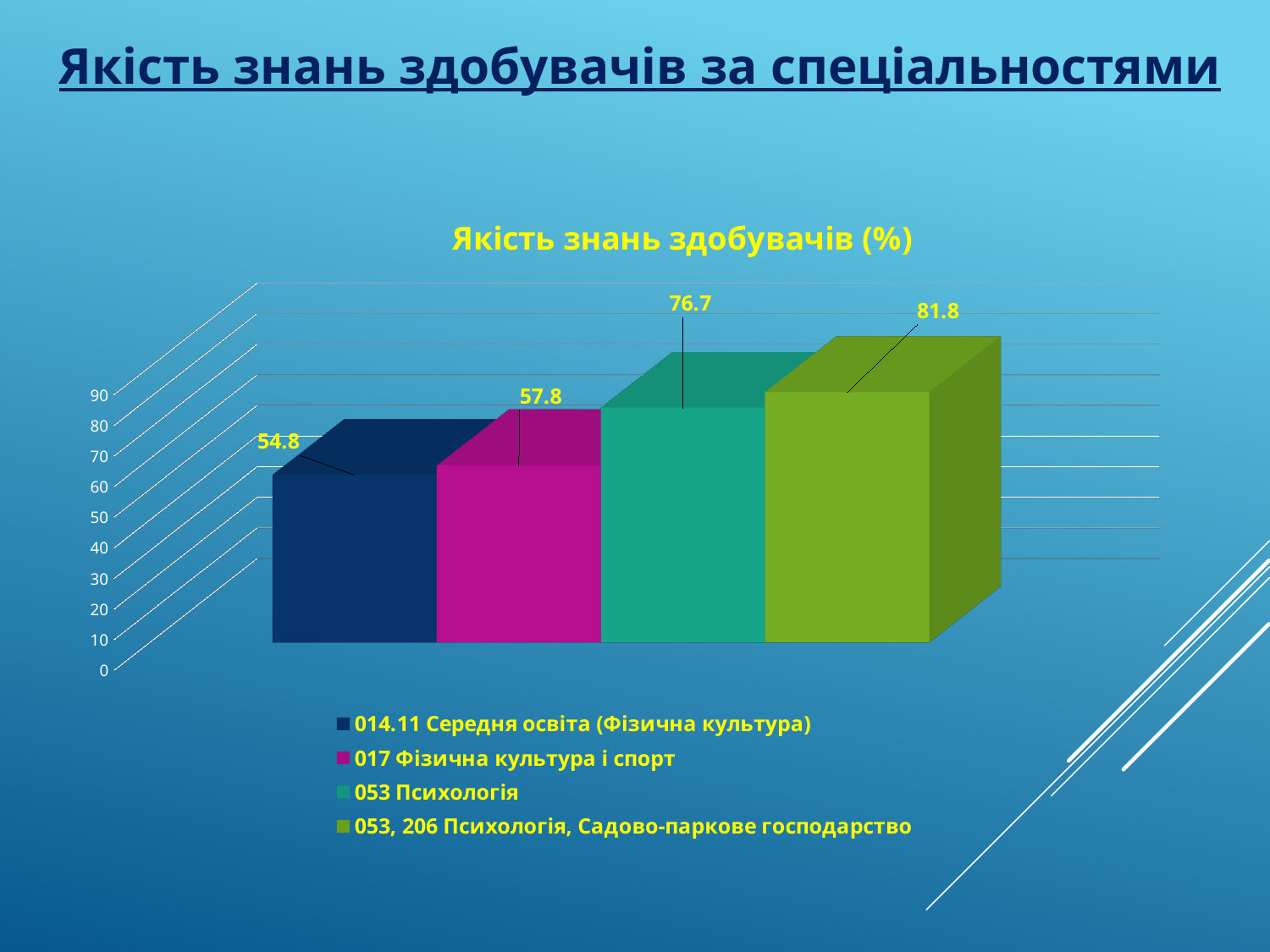
What is the value for 017 Фізична культура і спорт? 57.8 What is the value for 053 Психологія? 76.7 Which specialty has the highest value? 053, 206 Психологія, Садово-паркове господарство What is the difference between the values for 053 Психологія and 017 Фізична культура і спорт? 18.9 What kind of chart is shown on the slide? Bar chart What is the difference between the values for 053, 206 Психологія, Садово-паркове господарство and 014.11 Середня освіта (Фізична культура)? 27 How many bars are plotted in the chart? 4 What is the value for 053, 206 Психологія, Садово-паркове господарство? 81.8 Which specialty has the lowest value? 014.11 Середня освіта (Фізична культура) Which is larger, the value for 053 Психологія or the value for 017 Фізична культура і спорт? 053 Психологія What is the title of the chart? Якість знань здобувачів (%) What is the value for 014.11 Середня освіта (Фізична культура)? 54.8